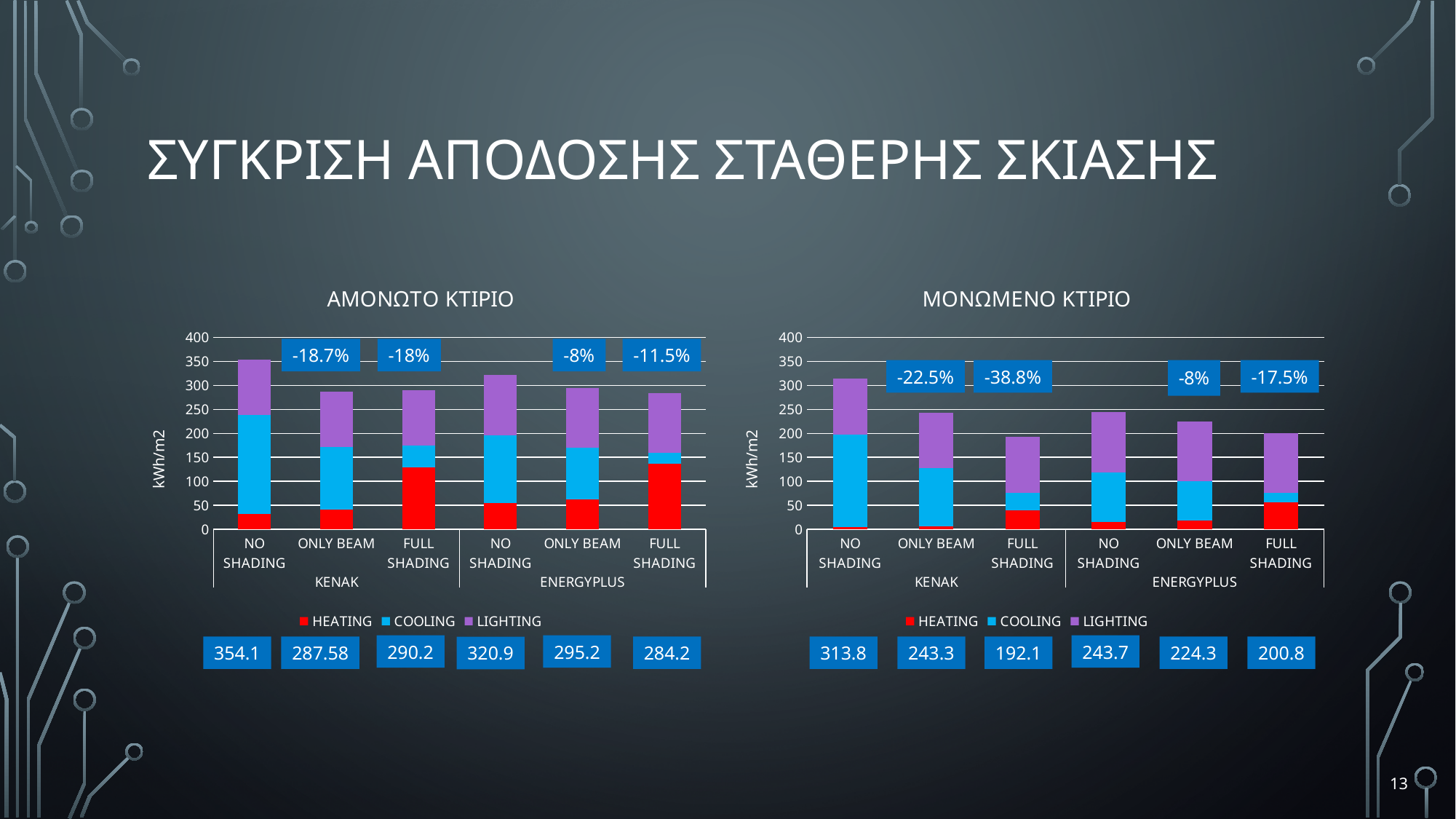
In the ΜΟΝΩΜΕΝΟ ΚΤΙΡΙΟ chart, which bar has the highest total? KENAK NO SHADING In the ΑΜΟΝΩΤΟ ΚΤΙΡΙΟ chart, what percentage change is shown for ENERGYPLUS FULL SHADING? -11.5% What kind of chart is the ΑΜΟΝΩΤΟ ΚΤΙΡΙΟ chart on the left? Stacked bar chart How many bars are plotted in the ΑΜΟΝΩΤΟ ΚΤΙΡΙΟ chart? 6 In the ΑΜΟΝΩΤΟ ΚΤΙΡΙΟ chart, what total is printed under the KENAK NO SHADING bar? 354.1 In the ΑΜΟΝΩΤΟ ΚΤΙΡΙΟ chart, which bar has the lowest total? ENERGYPLUS FULL SHADING In the ΜΟΝΩΜΕΝΟ ΚΤΙΡΙΟ chart, what percentage change is shown for KENAK FULL SHADING? -38.8% In the ΑΜΟΝΩΤΟ ΚΤΙΡΙΟ chart, is the total for KENAK ONLY BEAM greater or less than 300? less How many series does the legend of the ΜΟΝΩΜΕΝΟ ΚΤΙΡΙΟ chart list? 3 Which series is shown in red in the legend of the ΑΜΟΝΩΤΟ ΚΤΙΡΙΟ chart? HEATING In the ΜΟΝΩΜΕΝΟ ΚΤΙΡΙΟ chart, what is the difference between the totals of ENERGYPLUS NO SHADING and ENERGYPLUS FULL SHADING? 42.9 In the ΜΟΝΩΜΕΝΟ ΚΤΙΡΙΟ chart, what total is printed under the KENAK FULL SHADING bar? 192.1